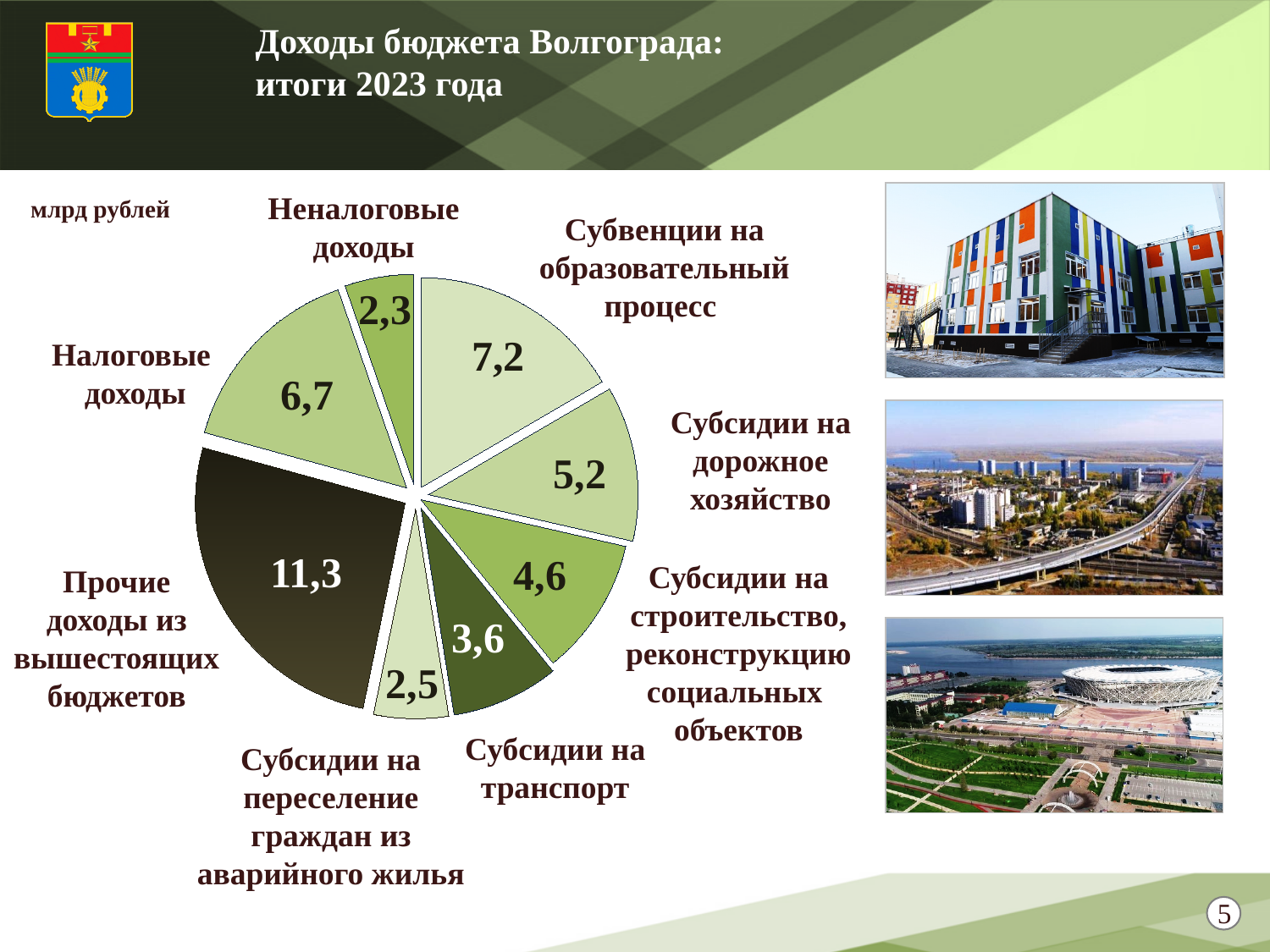
Which category has the largest slice in the pie chart? Прочие доходы из вышестоящих бюджетов In what units are the values in the pie chart given? млрд рублей Which is larger: «Субсидии на дорожное хозяйство» or «Субсидии на строительство, реконструкцию социальных объектов»? Субсидии на дорожное хозяйство Which category has the smallest slice in the pie chart? Неналоговые доходы What is the total of all slices in the pie chart? 43,4 How many slices does the pie chart have? 8 What is the value for «Субвенции на образовательный процесс»? 7,2 What is the difference between «Прочие доходы из вышестоящих бюджетов» and «Налоговые доходы»? 4,6 What is the value for «Субсидии на транспорт»? 3,6 What type of chart is shown on the slide? pie chart What is the value for «Субсидии на переселение граждан из аварийного жилья»? 2,5 What is the value for «Налоговые доходы» in the pie chart? 6,7